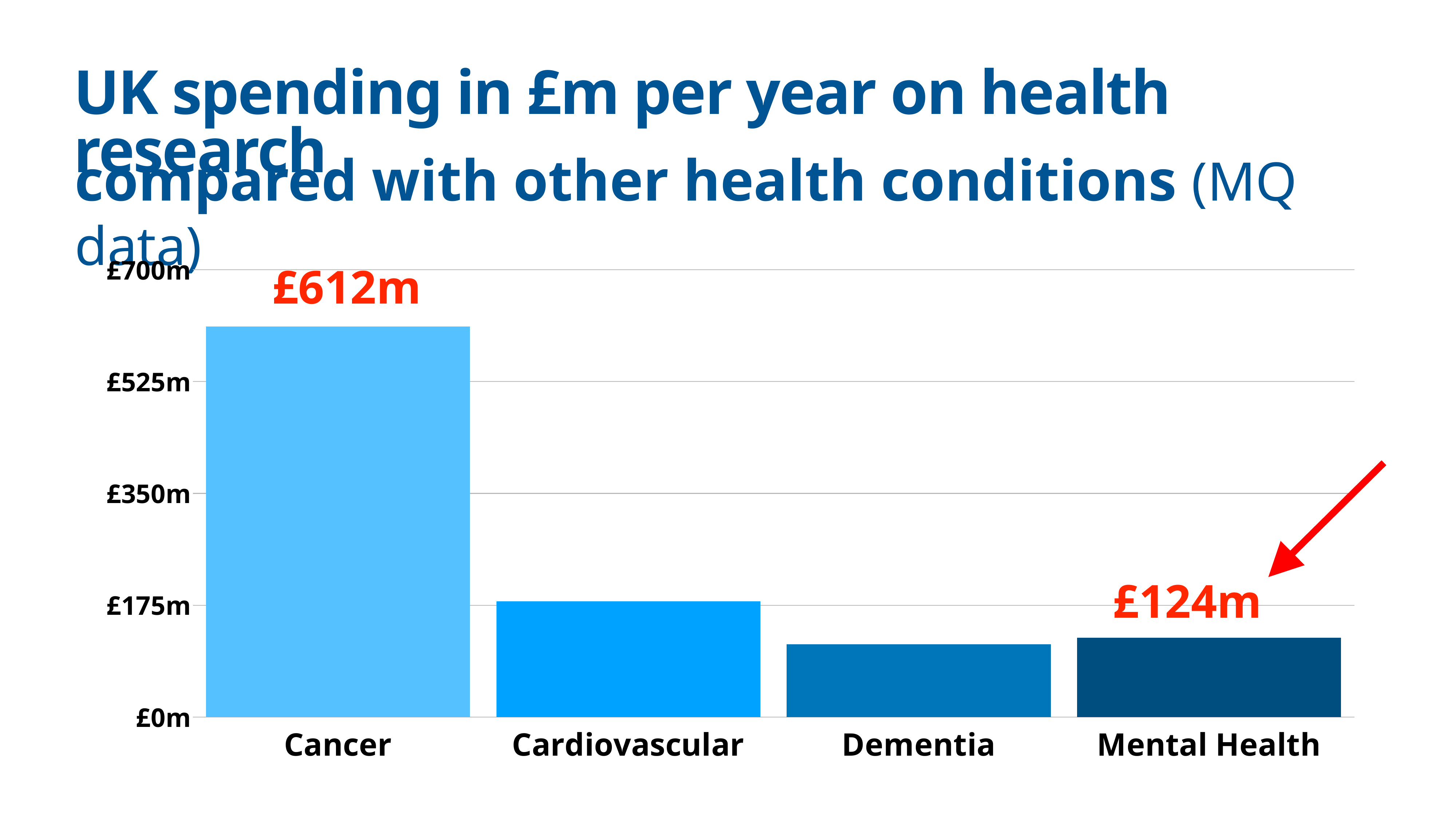
What kind of chart is shown on the slide? bar chart Is the value for Cancer greater or less than £525m? greater How many categories are shown on the x axis? 4 Which category has the highest value? Cancer What is the difference between the values for Cancer and Mental Health? £488m What is the value for Mental Health? £124m Is the value for Cardiovascular greater or less than £350m? less What is the value for Cancer? £612m Which is larger, the value for Cancer or the value for Cardiovascular? Cancer Which category does the red arrow point to? Mental Health Is the value for Dementia greater or less than £175m? less Which is larger, the value for Cardiovascular or the value for Dementia? Cardiovascular